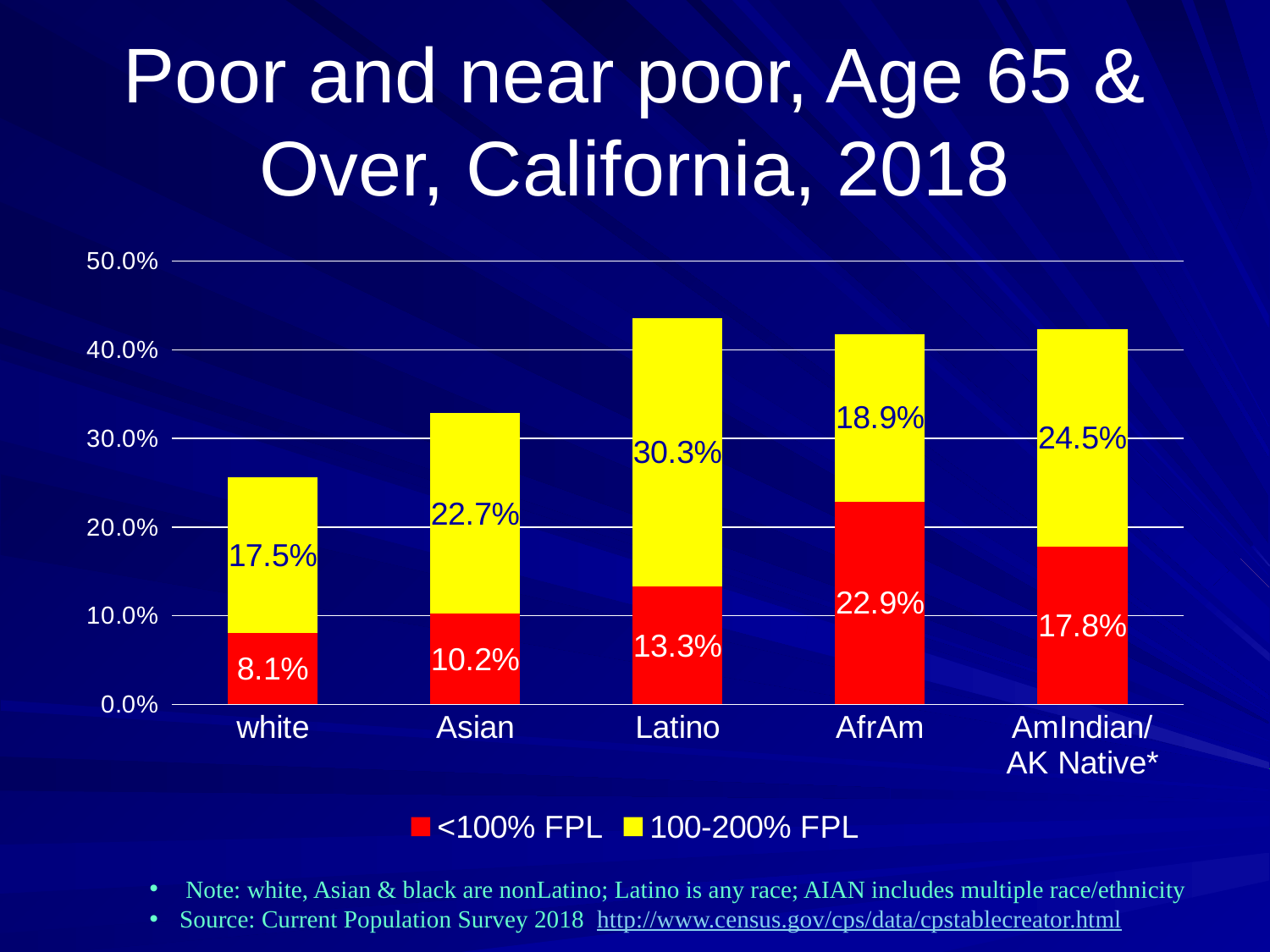
What is the total of the stacked bar for white? 25.6% What is the difference between the 100-200% FPL values for Latino and Asian? 7.6% How many series does the legend list? 2 What is the <100% FPL value for AfrAm? 22.9% What is the <100% FPL value for Latino? 13.3% Which category has the highest <100% FPL value? AfrAm Which category has the lowest 100-200% FPL value? white What kind of chart is shown on the slide? Stacked bar chart What is the total of the stacked bar for Latino? 43.6% What is the 100-200% FPL value for AmIndian/AK Native*? 24.5% Which is larger: the <100% FPL value for Asian or for white? Asian How many categories are shown on the x axis? 5